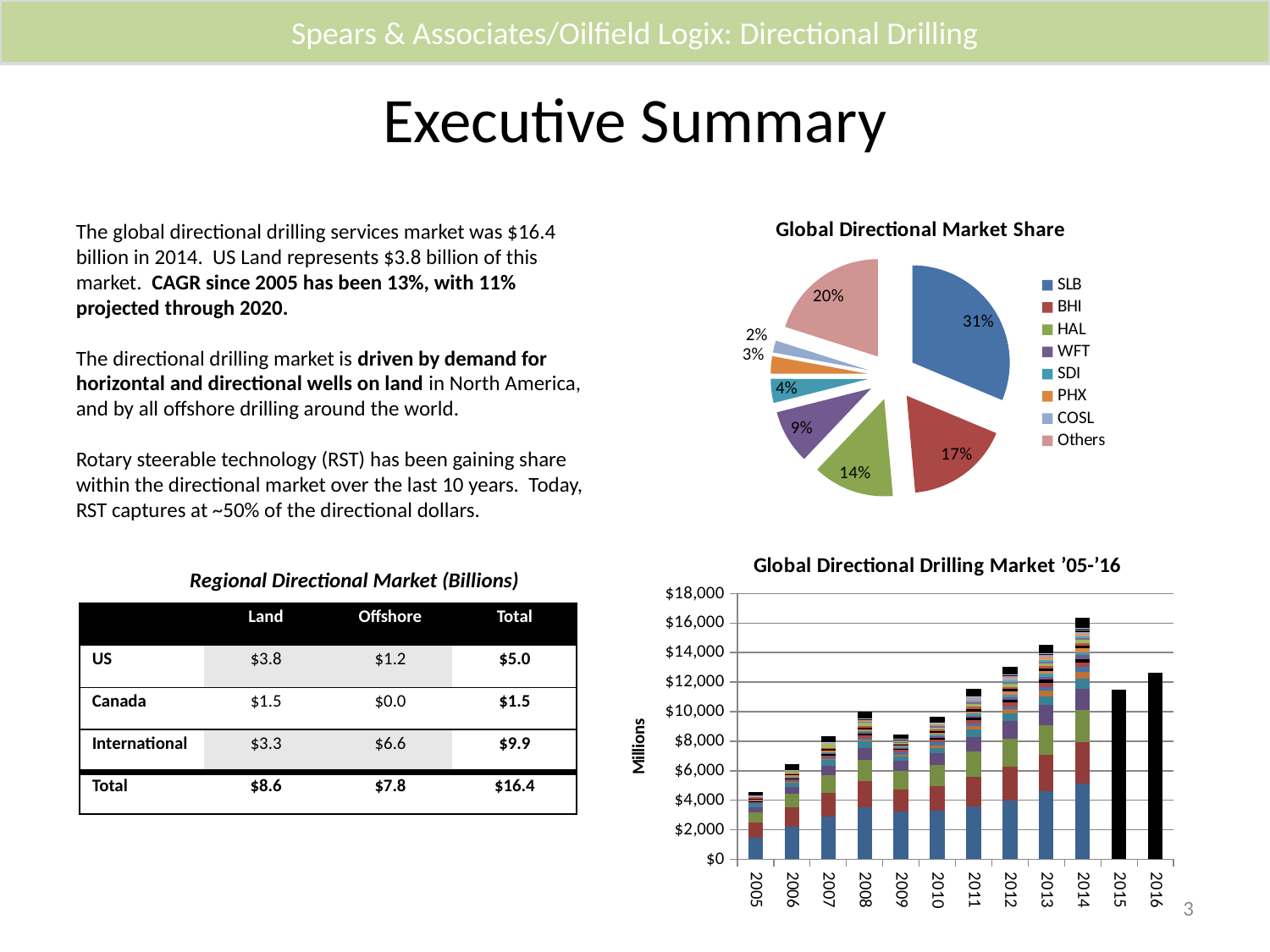
What kind of chart is the Global Directional Market Share chart? Pie chart In the Global Directional Market Share pie chart, what share does SLB hold? 31% In the Global Directional Market Share pie chart, which is larger, the share for Others or the share for BHI? Others In the Global Directional Market Share pie chart, which named company has the largest share? SLB In the Global Directional Drilling Market '05-'16 chart, is the total for 2014 greater or less than $16,000? greater In the Global Directional Drilling Market '05-'16 chart, is the value for 2015 greater or less than $12,000? less How many years are shown on the x axis of the Global Directional Drilling Market '05-'16 chart? 12 In the Global Directional Market Share pie chart, what share does HAL hold? 14% In the Global Directional Market Share pie chart, which company has the smallest share? COSL What kind of chart is the Global Directional Drilling Market '05-'16 chart? Stacked bar chart How many entries does the legend of the Global Directional Market Share pie chart list? 8 In the Global Directional Market Share pie chart, how many percentage points larger is BHI's share than WFT's share? 8 percentage points